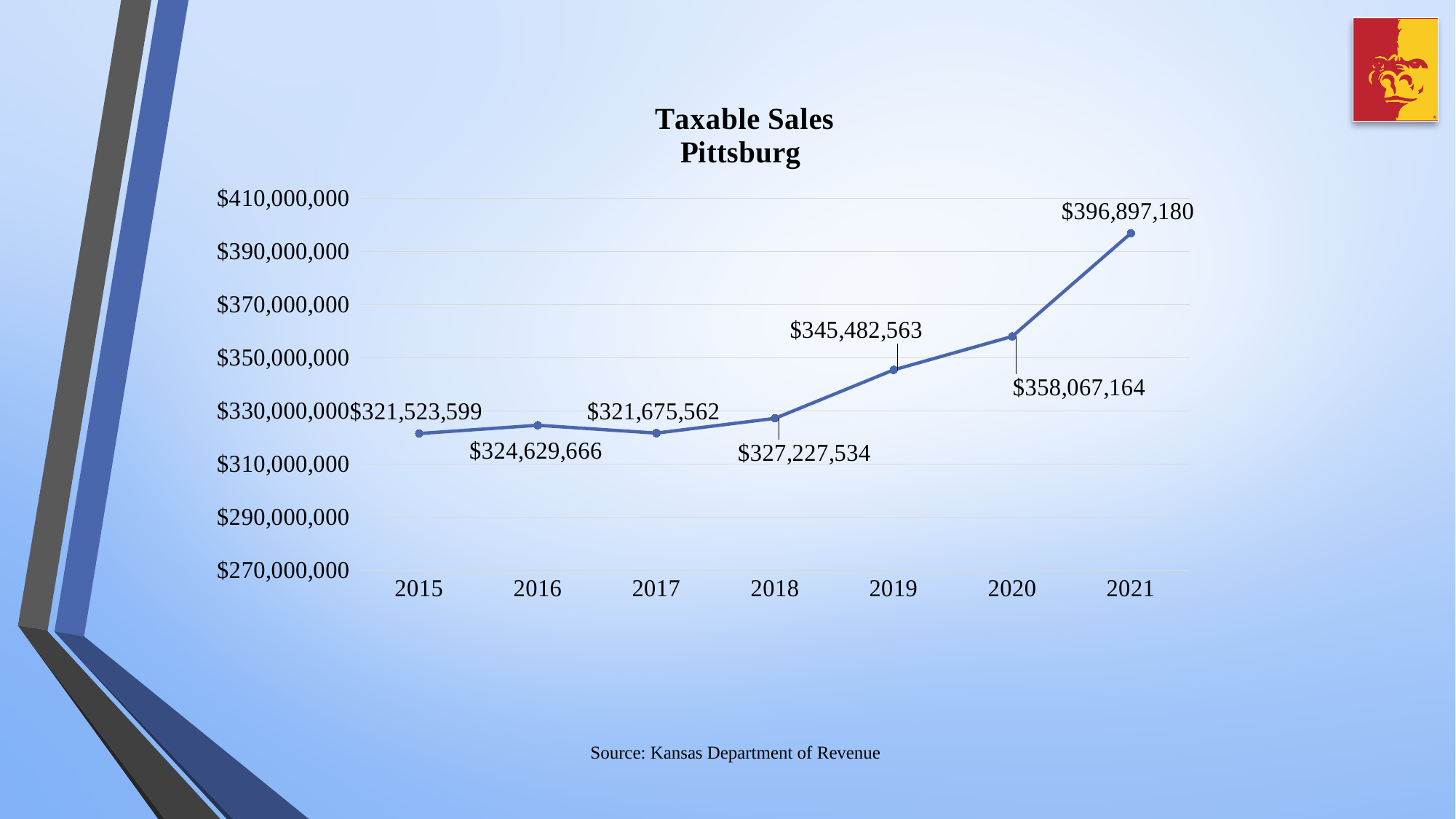
What is the title of the chart? Taxable Sales Pittsburg How many years are plotted on the chart? 7 By how much did taxable sales increase from 2020 to 2021? $38,830,016 Which year had the highest taxable sales? 2021 What is the overall trend in taxable sales from 2015 to 2021? Rising Which year had the lowest taxable sales? 2015 What is the difference in taxable sales between 2019 and 2018? $18,255,029 What were taxable sales in Pittsburg in 2021? $396,897,180 Were taxable sales higher in 2019 or in 2020? 2020 What were taxable sales in Pittsburg in 2016? $324,629,666 What type of chart is shown on the slide? Line chart What were taxable sales in Pittsburg in 2018? $327,227,534